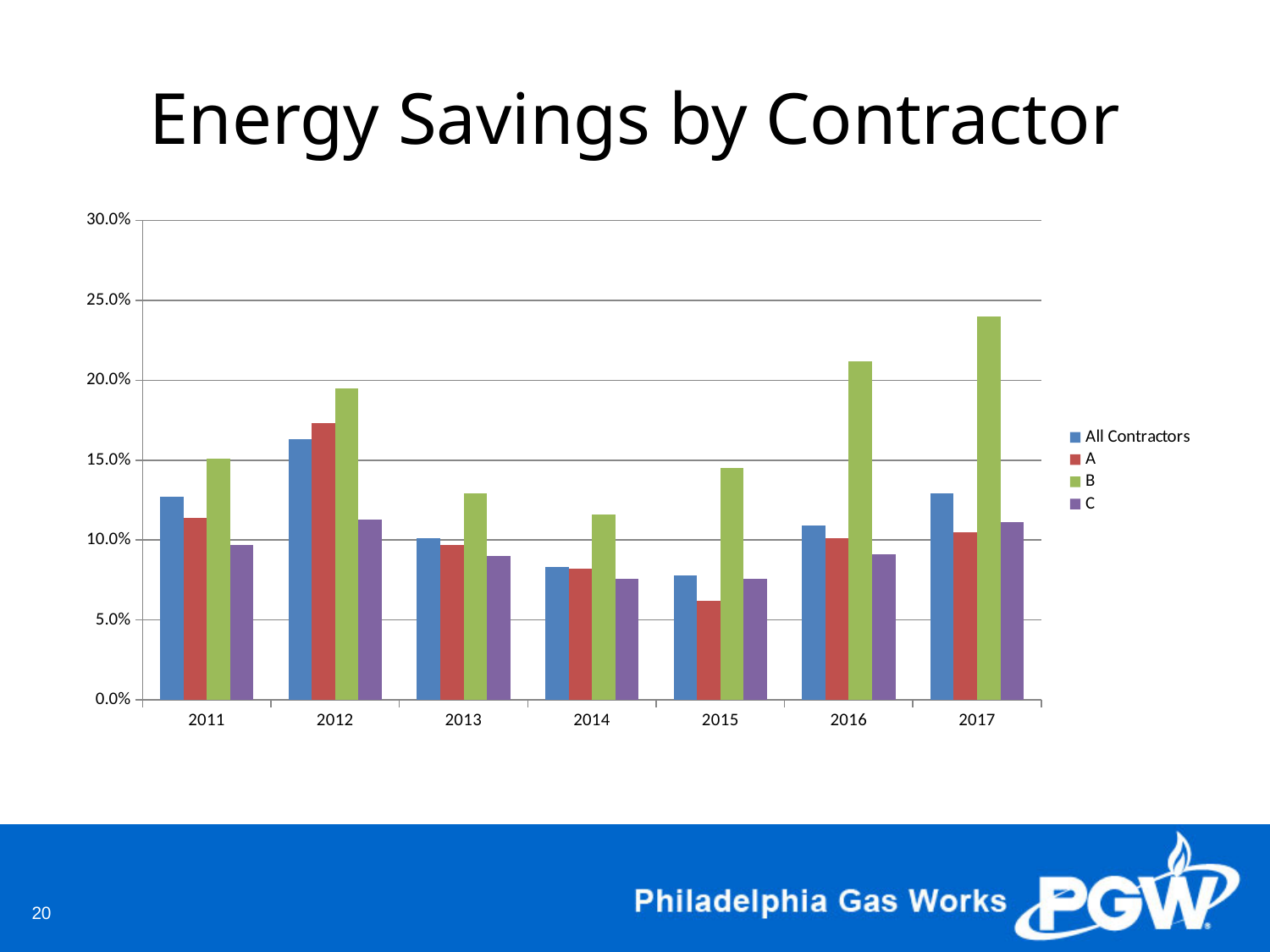
Does the value for contractor B rise or fall from 2014 to 2017? Rise In 2016, which is larger: the value for contractor B or contractor C? B What is the title of the chart? Energy Savings by Contractor Is the value for All Contractors in 2012 greater or less than 15.0%? greater Is the value for contractor A in 2015 greater or less than 10.0%? less How many years are shown on the x axis? 7 Is the value for contractor C in 2014 greater or less than 10.0%? less What kind of chart is shown on the slide? Bar chart How many series does the legend list? 4 In which year is the value for contractor B highest? 2017 In which year is the value for contractor A lowest? 2015